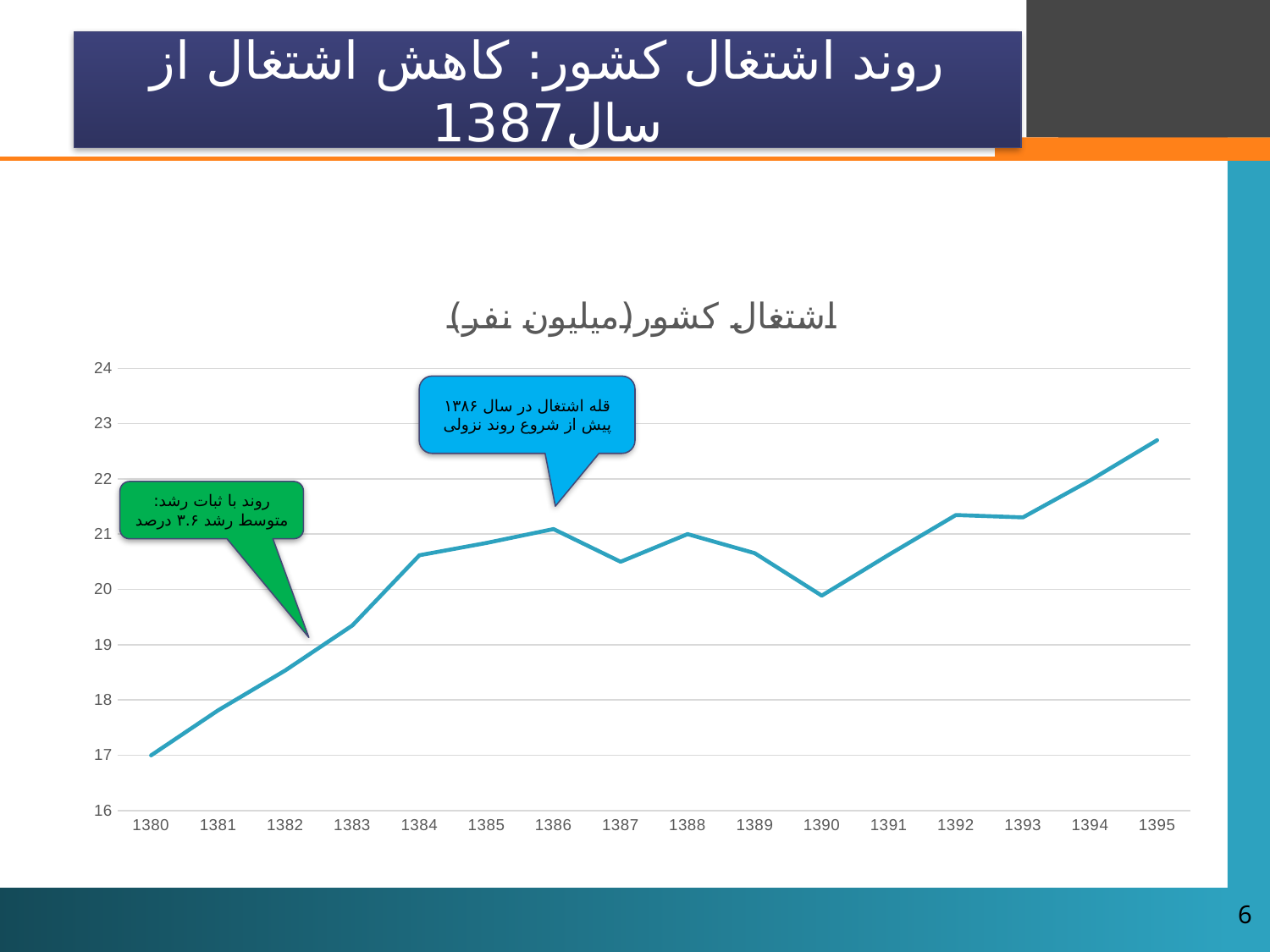
Which year has the highest employment value in the chart? 1395 Is the value for 1383 greater or less than 20? less How many years are plotted along the x axis of the chart? 16 Is the value for 1392 greater or less than 21? greater Is the value for 1381 greater or less than 19? less Which year has the lowest employment value in the chart? 1380 Do the values rise or fall from 1386 to 1390? fall Which year has the larger value, 1386 or 1390? 1386 What is the title of the chart? اشتغال کشور(میلیون نفر) Do the values rise or fall from 1390 to 1395? rise What kind of chart is shown on the slide? line chart